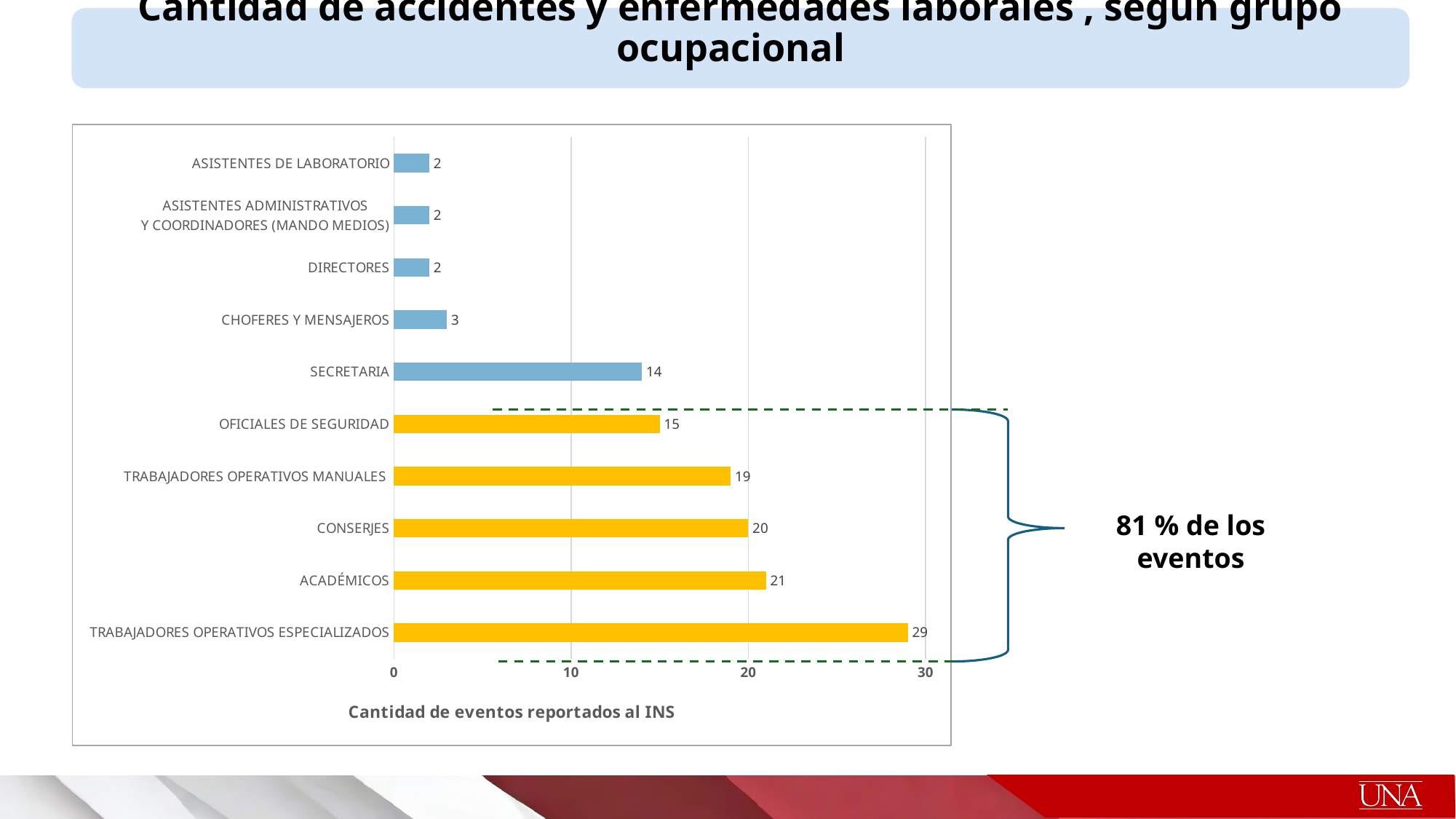
According to the annotation, what share of the events do the yellow bars represent? 81 % What is the x-axis title of the chart? Cantidad de eventos reportados al INS What is the difference between the values for TRABAJADORES OPERATIVOS ESPECIALIZADOS and OFICIALES DE SEGURIDAD? 14 What is the value for CHOFERES Y MENSAJEROS? 3 What is the difference between the values for ACADÉMICOS and CONSERJES? 1 Which is larger, the value for TRABAJADORES OPERATIVOS MANUALES or the value for SECRETARIA? TRABAJADORES OPERATIVOS MANUALES What is the value for TRABAJADORES OPERATIVOS ESPECIALIZADOS? 29 Which occupational group has the highest number of reported events? TRABAJADORES OPERATIVOS ESPECIALIZADOS Is the value for CONSERJES greater or less than 10? greater What is the value for SECRETARIA? 14 What kind of chart is shown on the slide? Bar chart How many occupational groups are shown in the chart? 10